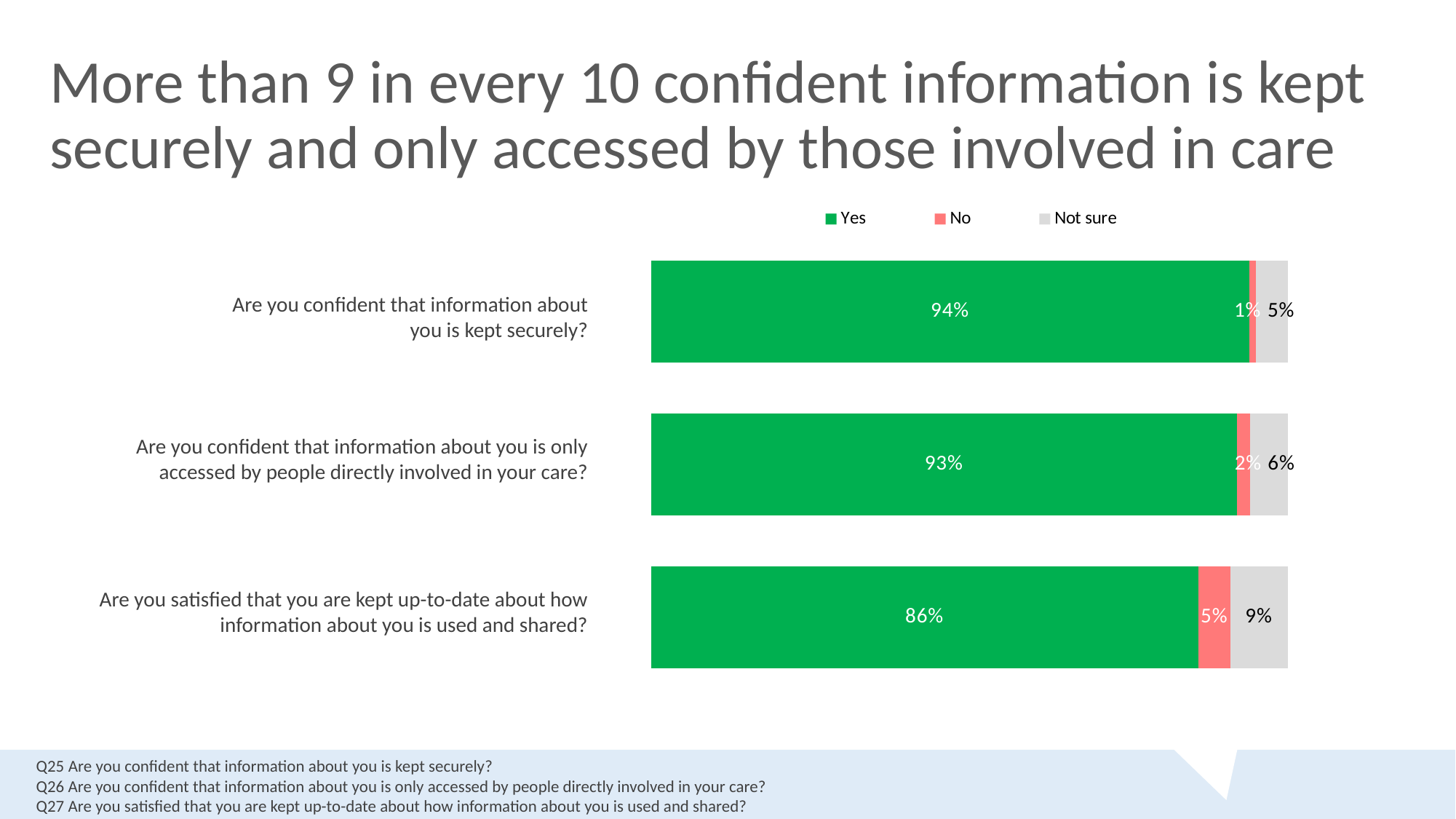
How many questions (bars) are shown in the chart? 3 Which question has the highest Yes percentage? Are you confident that information about you is kept securely? What percentage answered Not sure to "Are you satisfied that you are kept up-to-date about how information about you is used and shared?" 9% What is the total of the Yes, No and Not sure values for "Are you confident that information about you is only accessed by people directly involved in your care?" 101% What kind of chart is shown on the slide? Stacked bar chart Which has a larger No percentage: "Are you confident that information about you is kept securely?" or "Are you satisfied that you are kept up-to-date about how information about you is used and shared?" Are you satisfied that you are kept up-to-date about how information about you is used and shared? Which colour represents the Not sure series in the chart? Grey What percentage answered No to "Are you confident that information about you is only accessed by people directly involved in your care?" 2% How many series does the legend list? 3 What percentage answered Yes to "Are you confident that information about you is kept securely?" 94% Which question has the lowest Yes percentage? Are you satisfied that you are kept up-to-date about how information about you is used and shared? What is the difference in Yes percentage between "Are you confident that information about you is kept securely?" and "Are you satisfied that you are kept up-to-date about how information about you is used and shared?" 8%